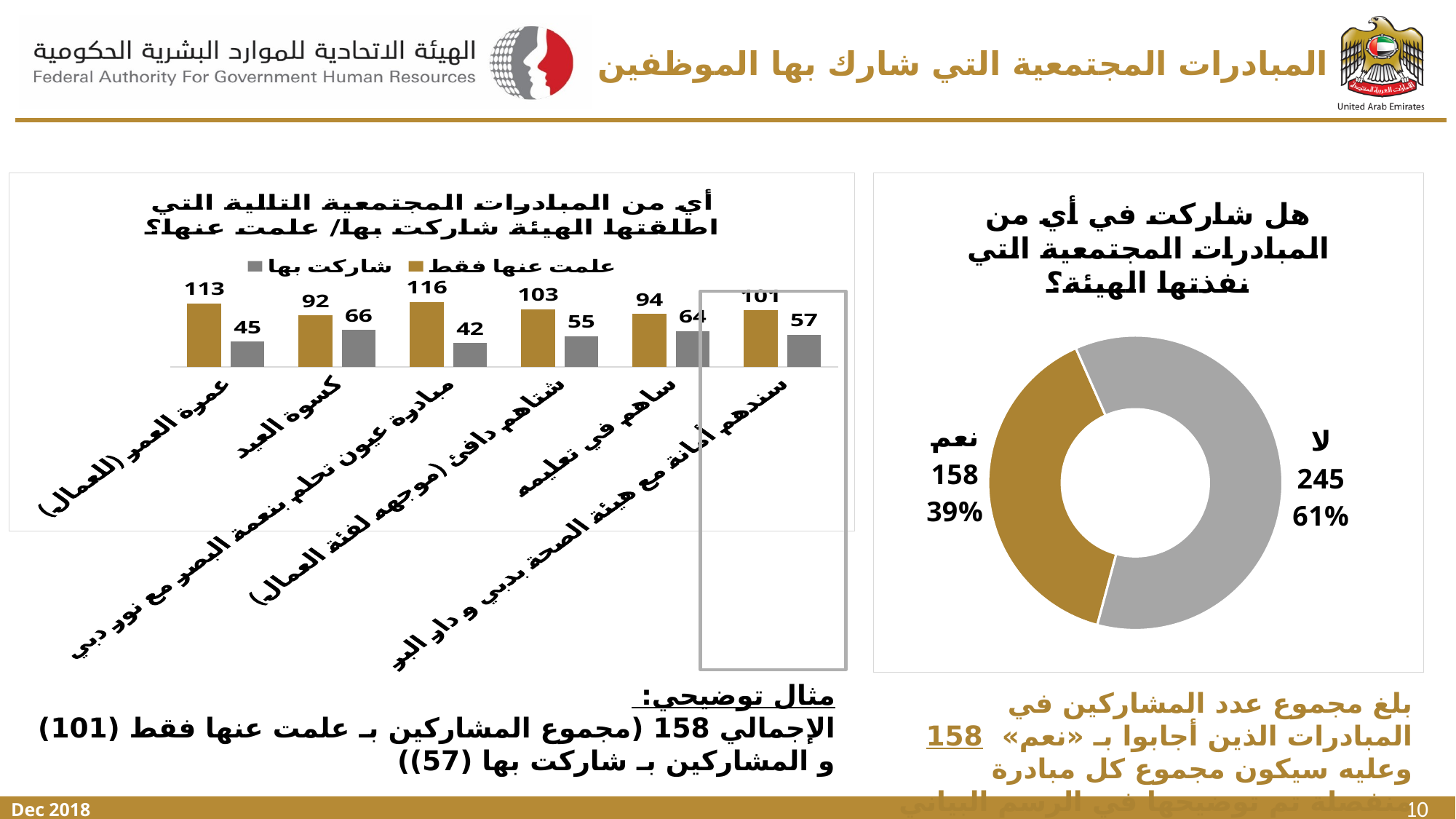
In the bar chart on the left, what is the total of 'علمت عنها فقط' and 'شاركت بها' for 'شتاهم دافئ (موجهه لفئة العمال)'? 158 In the bar chart on the left, which category has the lowest 'شاركت بها' value? مبادرة عيون تحلم بنعمة البصر مع نور دبي In the donut chart on the right, what share of respondents answered 'نعم'? 39% What kind of chart is the chart on the right of the slide? Donut (pie) chart In the bar chart on the left, what is the difference between 'علمت عنها فقط' and 'شاركت بها' for 'عمرة العمر (للعمال)'? 68 In the bar chart on the left, what is the value of 'شاركت بها' for 'ساهم في تعليمه'? 64 How many series does the legend of the bar chart on the left list? 2 In the bar chart on the left, what is the value of 'علمت عنها فقط' for 'كسوة العيد'? 92 How many categories are shown in the bar chart on the left? 6 In the bar chart on the left, which is larger for 'كسوة العيد': 'علمت عنها فقط' or 'شاركت بها'? علمت عنها فقط In the donut chart on the right, what is the value for 'لا'? 245 In the bar chart on the left, which category has the highest 'علمت عنها فقط' value? مبادرة عيون تحلم بنعمة البصر مع نور دبي